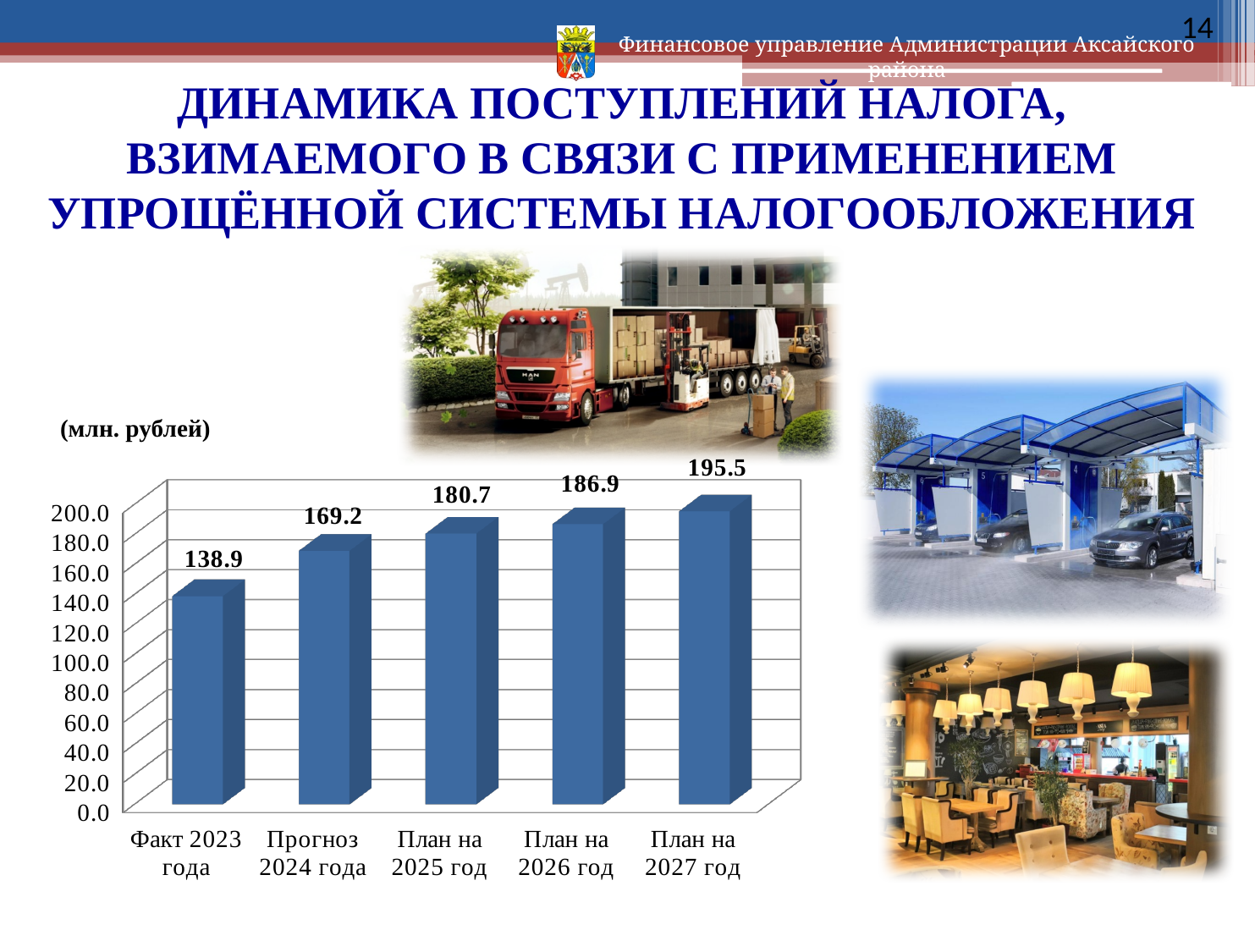
Which category has the highest value? План на 2027 год Is the value for Факт 2023 года greater or less than 160.0? less How many categories are shown on the x axis? 5 What kind of chart is shown on the slide? bar chart Which is larger, the value for План на 2025 год or the value for Прогноз 2024 года? План на 2025 год Do the values rise or fall from Факт 2023 года to План на 2027 год? rise What is the difference between the values for План на 2027 год and Факт 2023 года? 56.6 What is the difference between the values for План на 2025 год and Прогноз 2024 года? 11.5 What is the value for Прогноз 2024 года? 169.2 Which category has the lowest value? Факт 2023 года What is the value for Факт 2023 года? 138.9 What is the value for План на 2026 год? 186.9